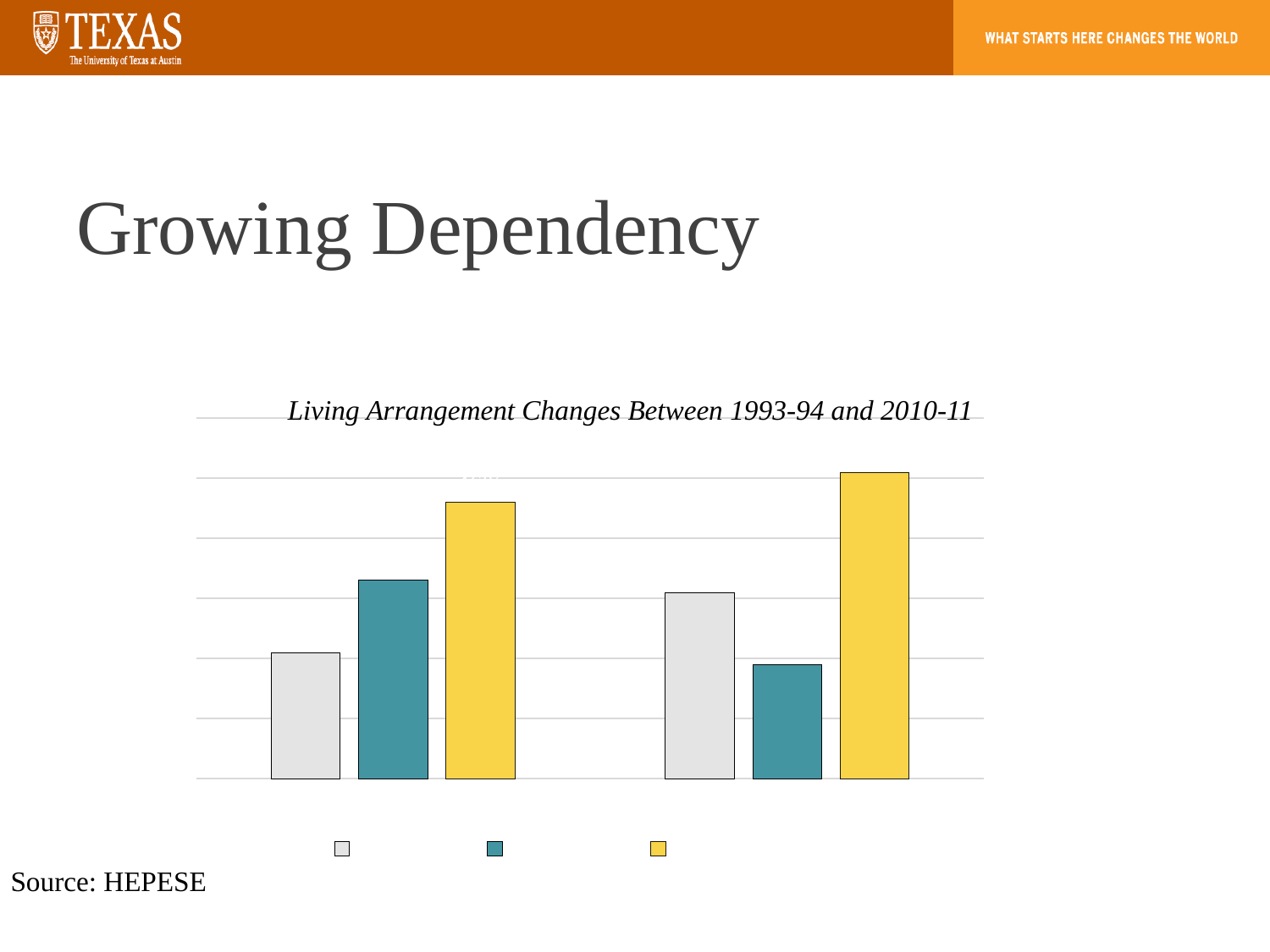
Is the teal bar in the left group taller or shorter than the teal bar in the right group? Taller Is the grey bar in the right group taller or shorter than the grey bar in the left group? Taller How many groups of bars are plotted on the chart? 2 In the left group of bars, which bar is the shortest? The grey bar In the left group of bars, which bar is the tallest? The yellow bar What colours are the three legend entries, from left to right? Grey, teal, yellow How many series does the legend list? 3 What kind of chart is shown on the slide? Bar chart In the right group of bars, which bar is the tallest? The yellow bar Is the yellow bar in the right group taller or shorter than the yellow bar in the left group? Taller What is the title of the chart? Living Arrangement Changes Between 1993-94 and 2010-11 In the right group of bars, which bar is the shortest? The teal bar